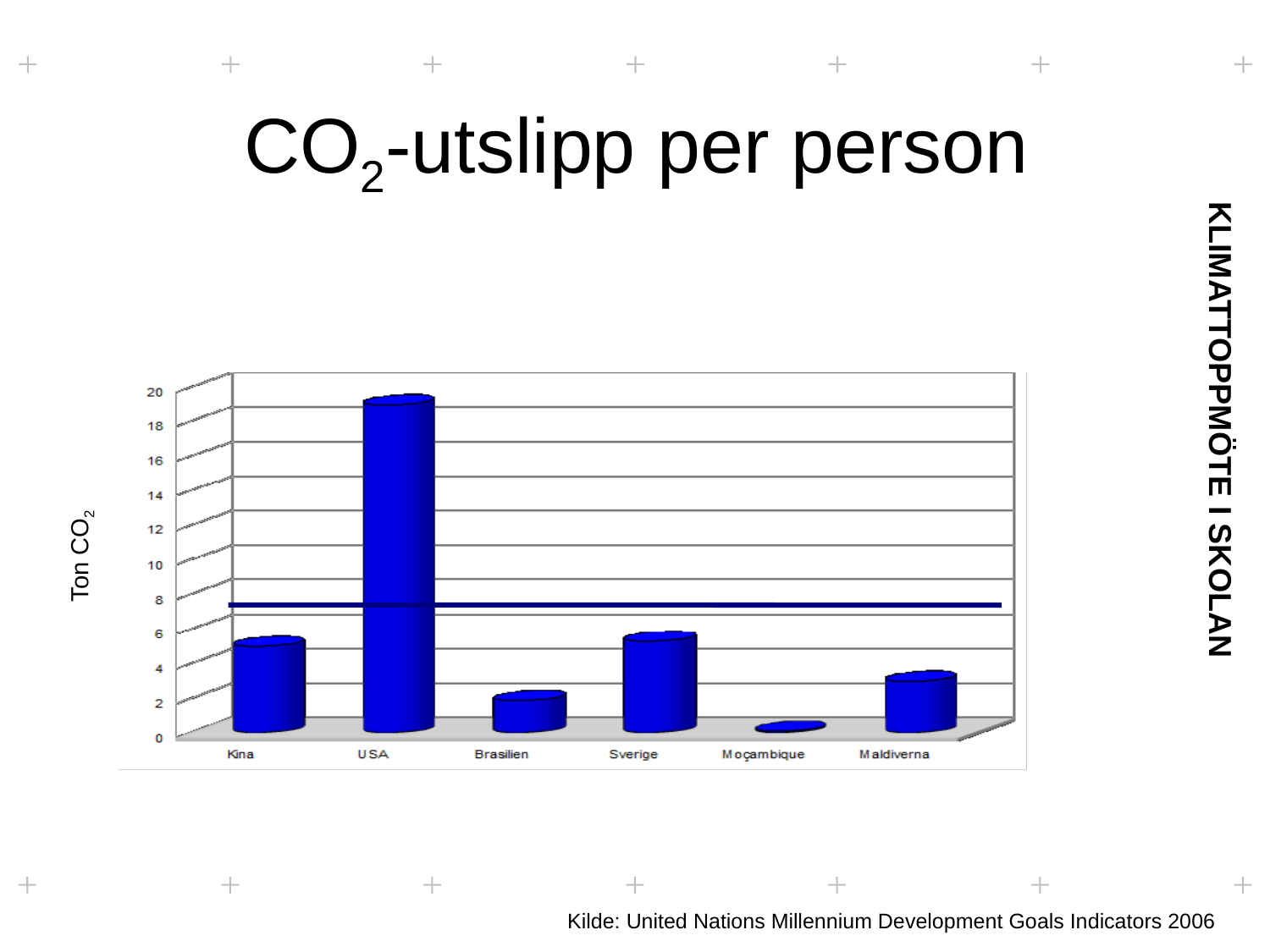
Is the value for Sverige greater or less than 8? less Is the value for Moçambique greater or less than 2? less Which country has the highest CO2 emissions per person in the chart? USA What is the label on the vertical axis of the chart? Ton CO2 Which has the larger value, USA or Kina? USA Is the value for Brasilien greater or less than 4? less Which country has the lowest CO2 emissions per person in the chart? Moçambique What kind of chart is shown on the slide? bar chart How many countries are shown on the x axis of the chart? 6 Which has the larger value, Sverige or Brasilien? Sverige